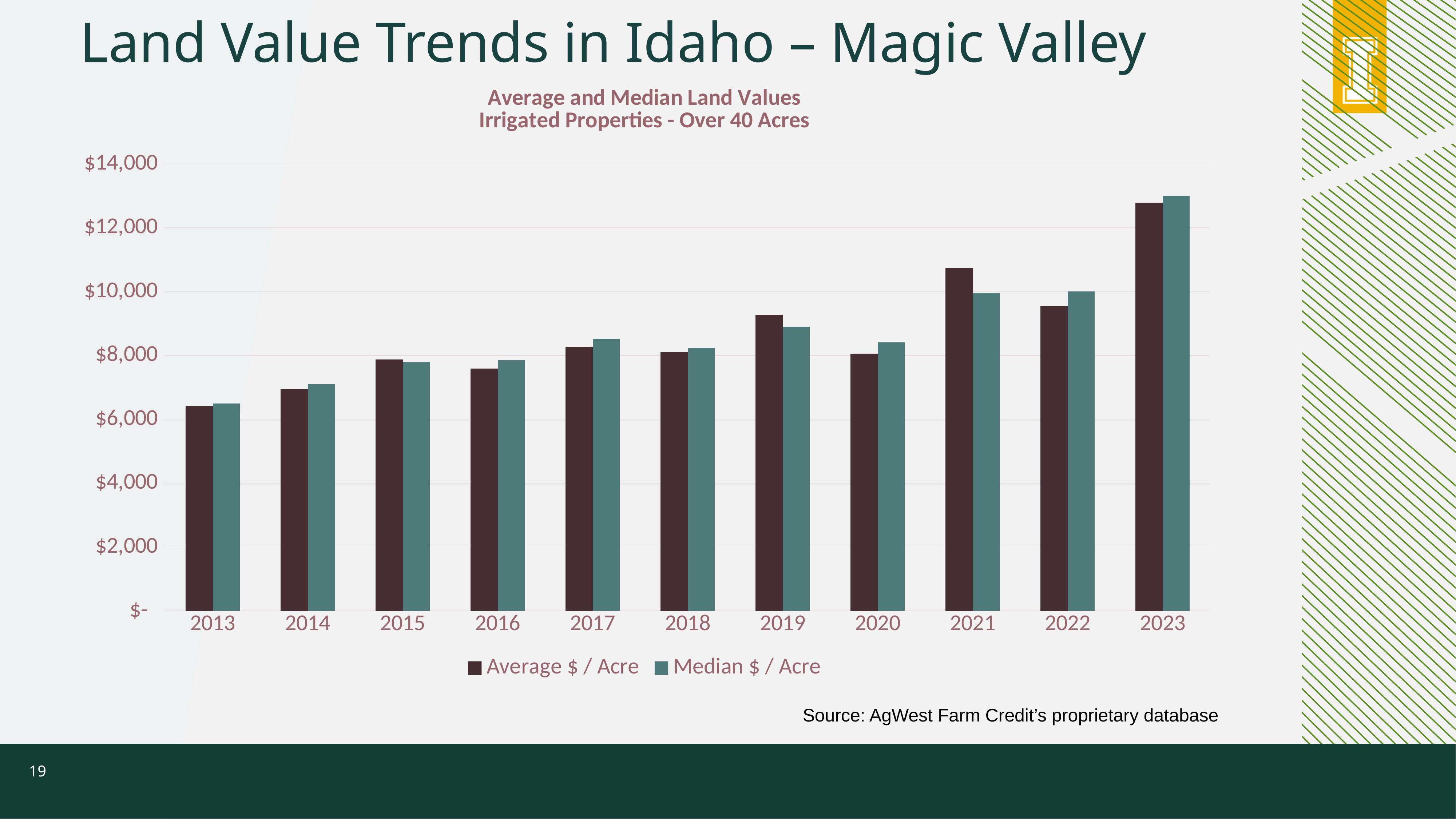
How many years are shown on the x axis of the chart? 11 Is the Median $ / Acre for 2023 greater or less than $12,000? greater Do the Average $ / Acre values generally rise or fall from 2013 to 2023? Rise Which year has the highest Average $ / Acre? 2023 How many series does the chart's legend list? 2 Is the Median $ / Acre for 2013 greater or less than $8,000? less What are the two entries in the chart's legend? Average $ / Acre and Median $ / Acre Is the Average $ / Acre for 2022 greater or less than $10,000? less What kind of chart is shown on the slide? Bar chart Which year has the lowest Median $ / Acre? 2013 In 2021, which is larger: Average $ / Acre or Median $ / Acre? Average $ / Acre